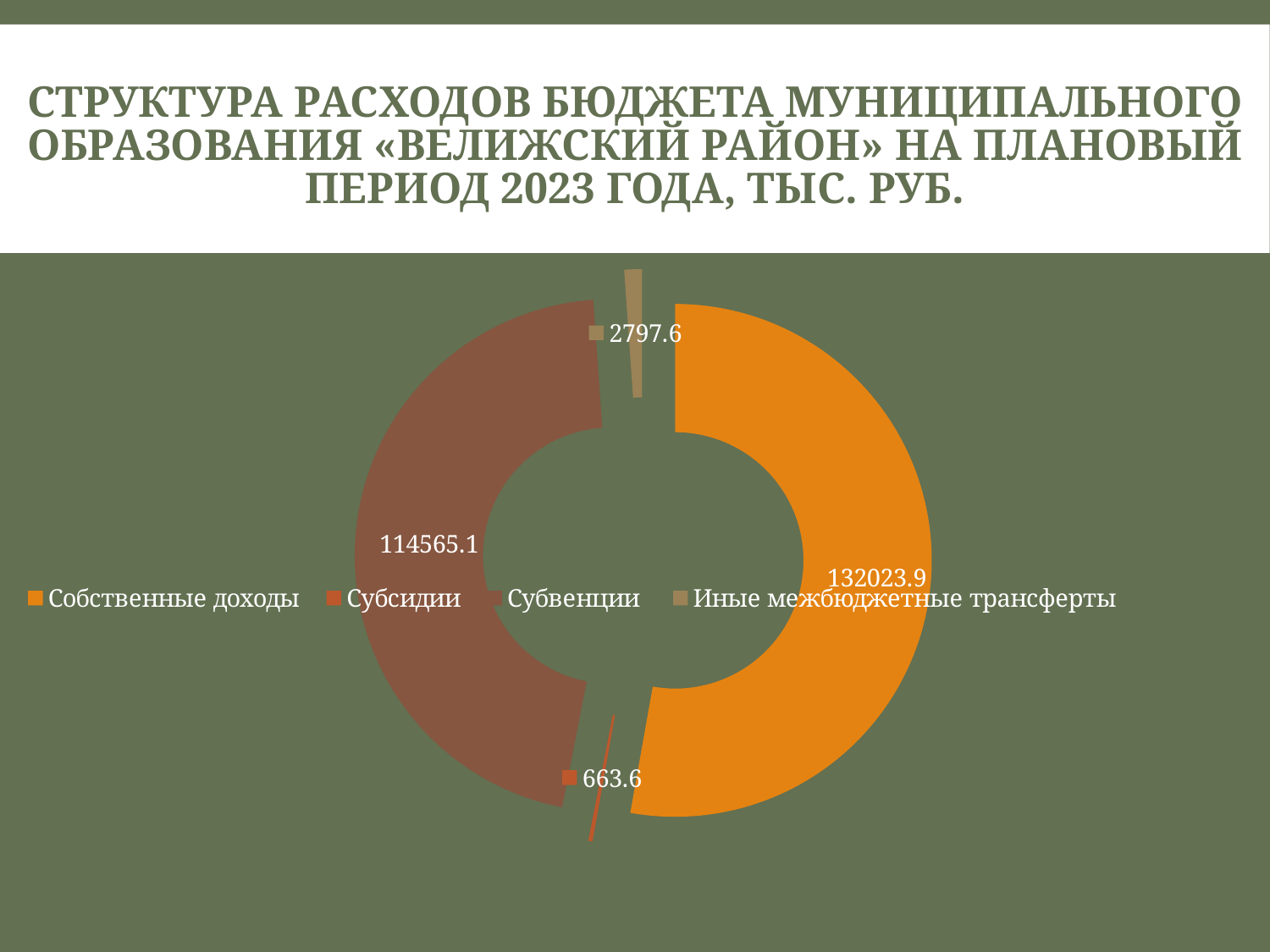
How many categories does the chart show? 4 What type of chart is shown on the slide? Doughnut (pie) chart What is the value for Иные межбюджетные трансферты? 2797.6 What is the difference between Собственные доходы and Субвенции? 17458.8 What is the value for Субвенции? 114565.1 What is the value for Субсидии? 663.6 Which is larger, Иные межбюджетные трансферты or Субсидии? Иные межбюджетные трансферты How many entries does the legend list? 4 Which category has the largest value? Собственные доходы What is the value for Собственные доходы? 132023.9 Which category has the smallest value? Субсидии What colour is the Собственные доходы segment? Orange